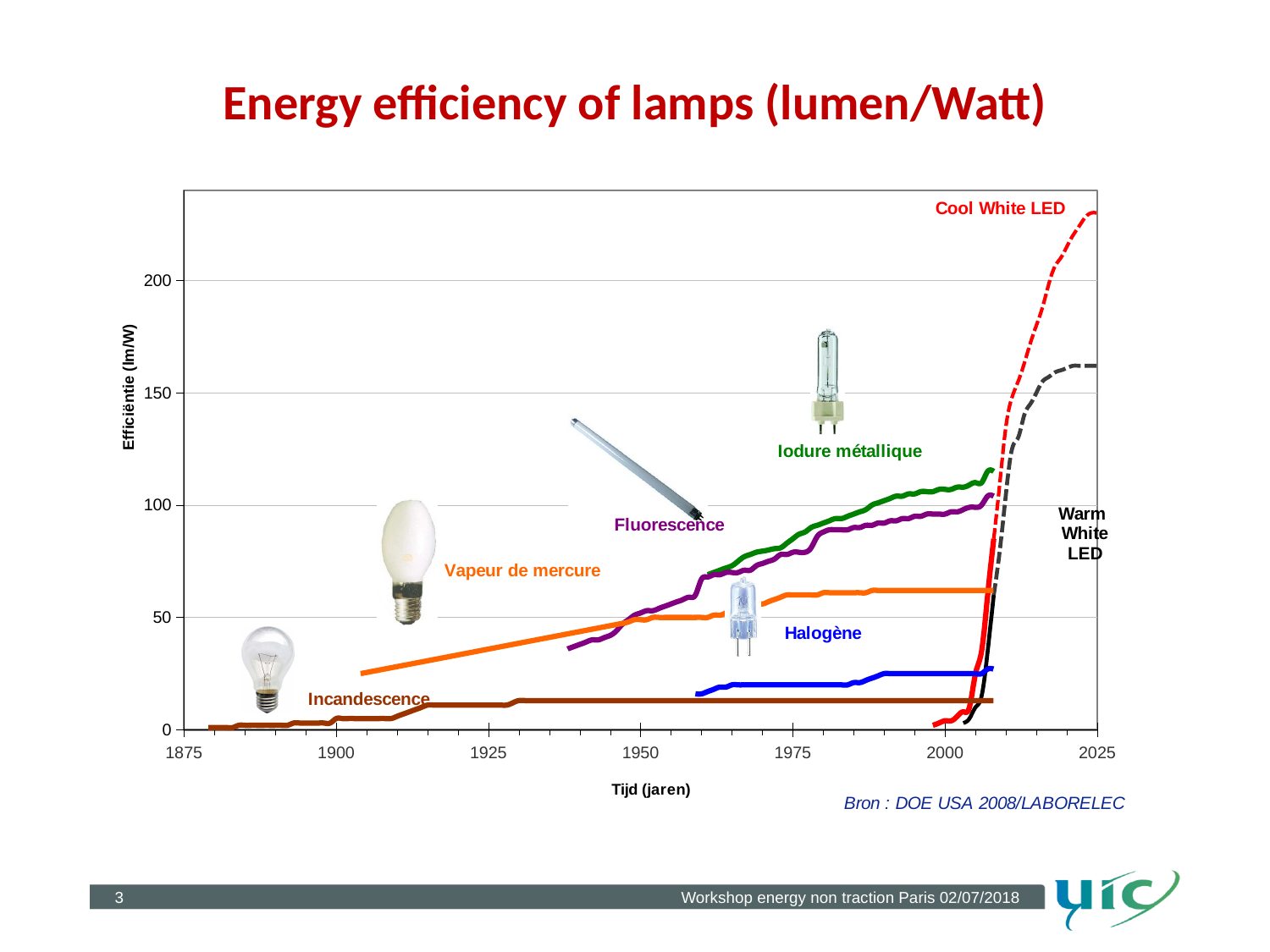
Is the value for Iodure métallique around the year 2000 greater or less than 100? greater Is the value for Cool White LED at 2025 greater or less than 200? greater Which lamp type reaches the highest efficiency on the chart? Cool White LED Does the efficiency of Iodure métallique rise or fall over time along the x axis? rise How many lamp types (series) are labelled on the chart? 7 Is the value for Incandescence around the year 2000 greater or less than 50? less What kind of chart is shown on the slide? line chart What is the label of the y axis? Efficiëntie (lm/W) Which lamp type has the lowest efficiency on the chart? Incandescence Which has the higher efficiency around the year 2000, Vapeur de mercure or Halogène? Vapeur de mercure